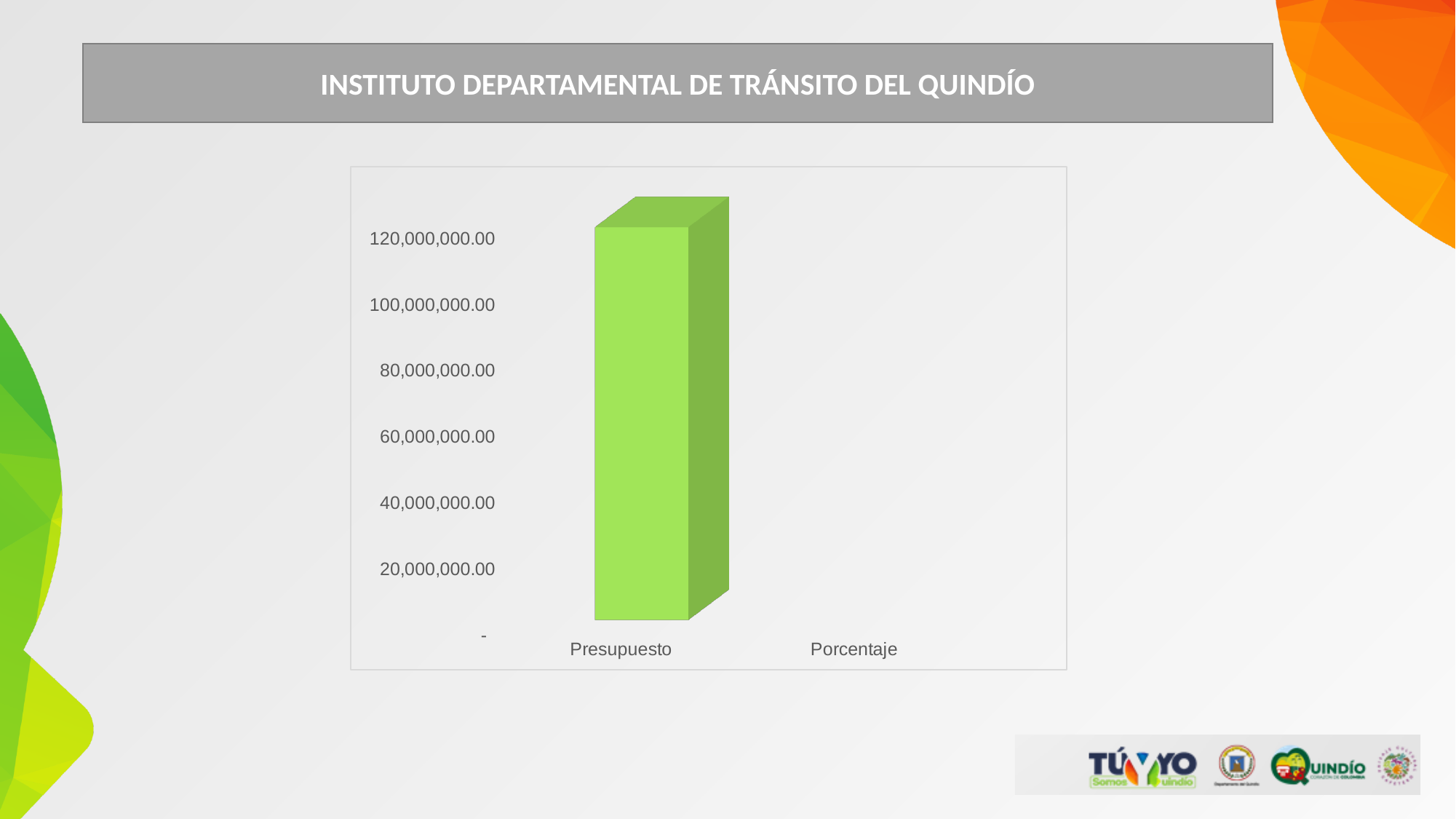
Is the value for Porcentaje greater or less than 20,000,000.00? less Which category has the lowest value in the chart? Porcentaje What kind of chart is shown on the slide? bar chart What colour is the bar for Presupuesto? green Is the value for Presupuesto greater or less than 100,000,000.00? greater Is the value for Presupuesto greater or less than 80,000,000.00? greater What is the highest labelled tick on the vertical axis of the chart? 120,000,000.00 How many categories are shown on the x axis of the chart? 2 Which is larger, the value for Presupuesto or the value for Porcentaje? Presupuesto Which category has the highest value in the chart? Presupuesto